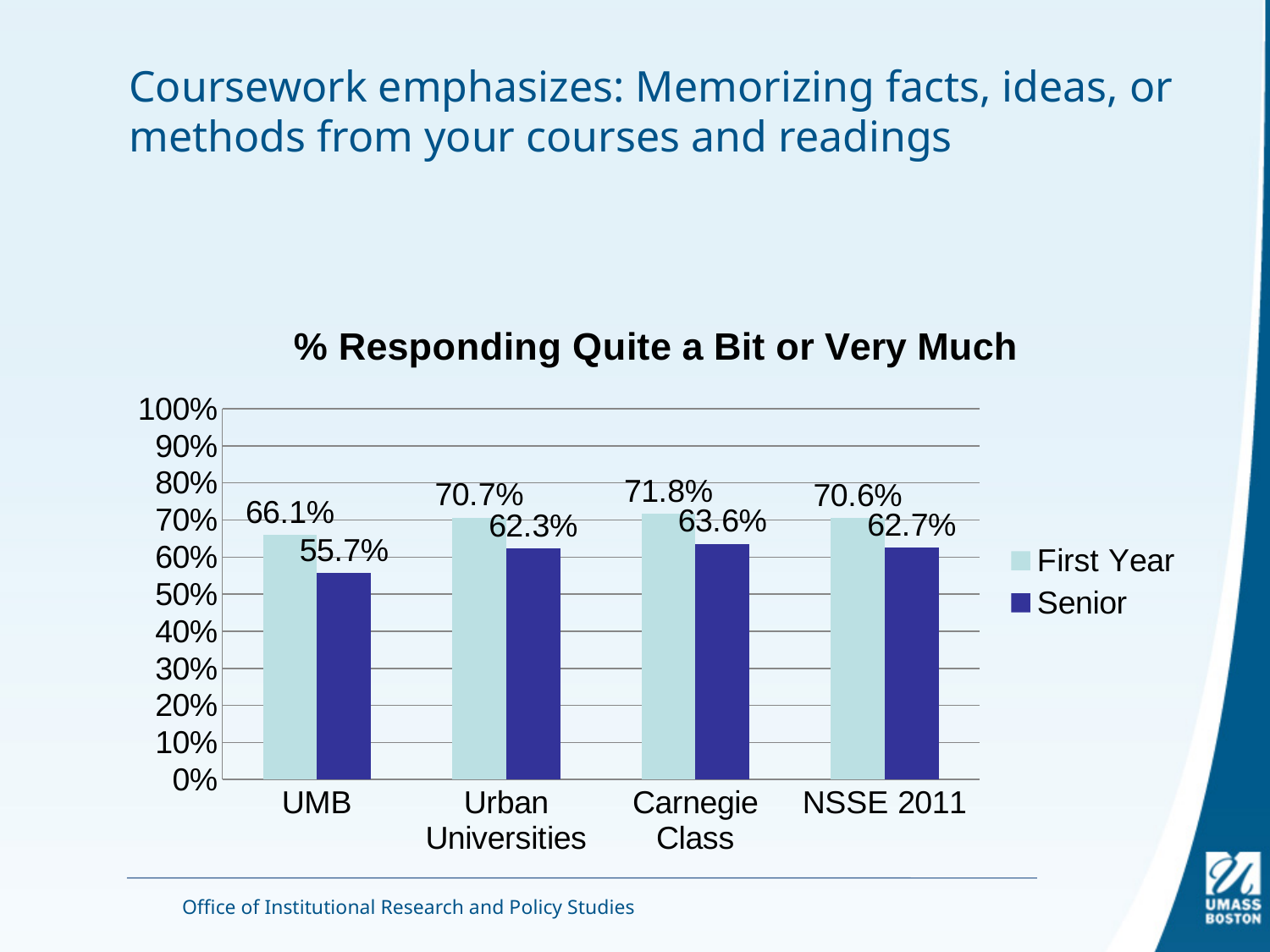
What is the Senior value for Carnegie Class? 63.6% Which category has the lowest Senior value? UMB What is the First Year value for UMB? 66.1% How many categories are shown on the x axis? 4 What is the title of the chart? % Responding Quite a Bit or Very Much What is the difference between the First Year and Senior values for UMB? 10.4% What is the Senior value for NSSE 2011? 62.7% What is the difference between the First Year values for Urban Universities and UMB? 4.6% Which is larger, the Senior value for Urban Universities or the Senior value for UMB? Urban Universities Which category has the highest First Year value? Carnegie Class How many series does the legend list? 2 What kind of chart is shown on the slide? Bar chart